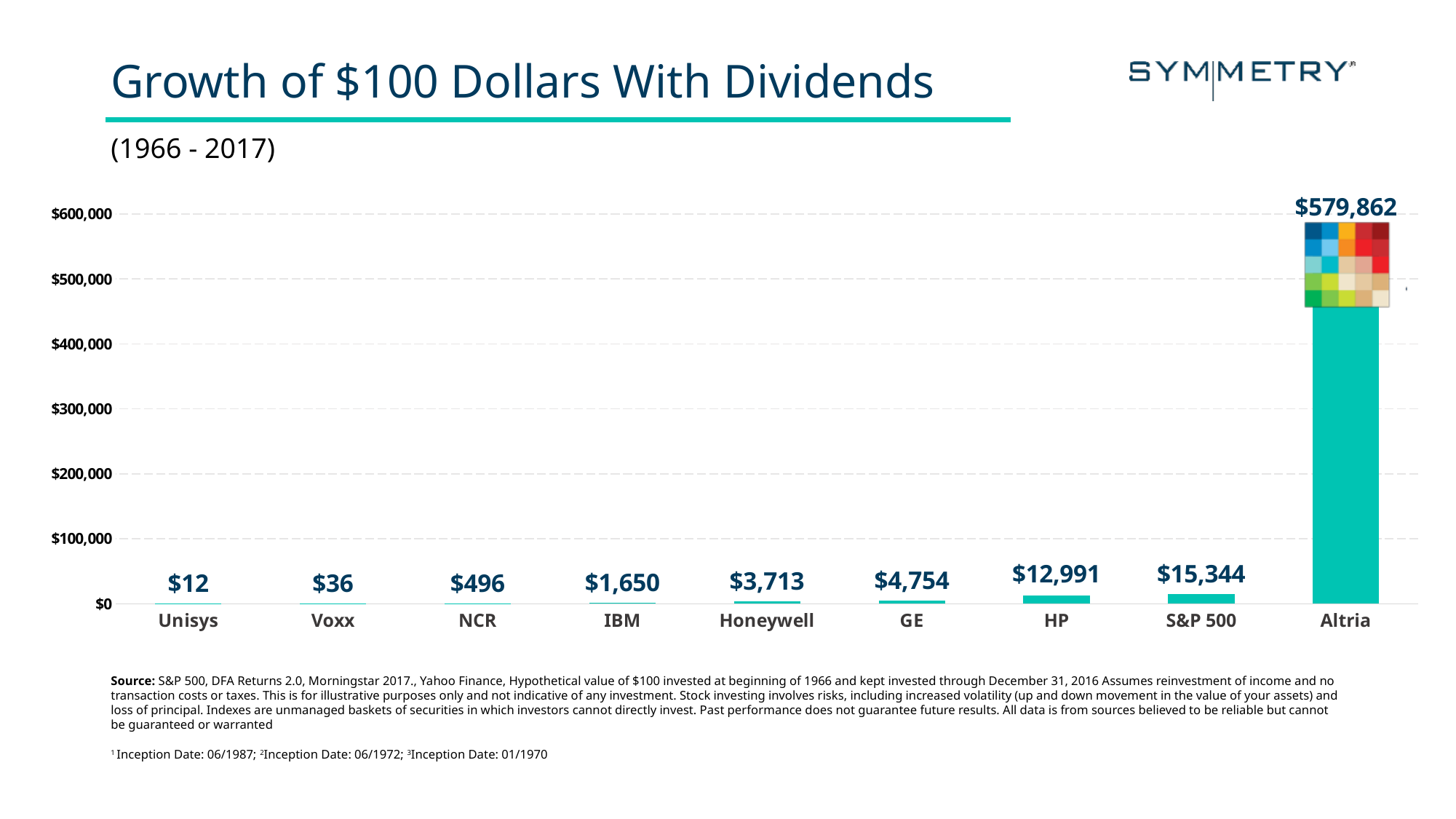
What is the value shown for IBM? $1,650 Which category has the lowest value? Unisys What is the value shown for the S&P 500? $15,344 What is the difference between the values for S&P 500 and HP? $2,353 Which category has the highest value? Altria What is the difference between the values for GE and Honeywell? $1,041 Is the value for Altria greater or less than $500,000? greater What is the value shown for Honeywell? $3,713 Which is larger, the value for NCR or the value for Voxx? NCR What is the value shown for Altria? $579,862 What kind of chart is shown on the slide? bar chart How many categories are shown on the x axis? 9